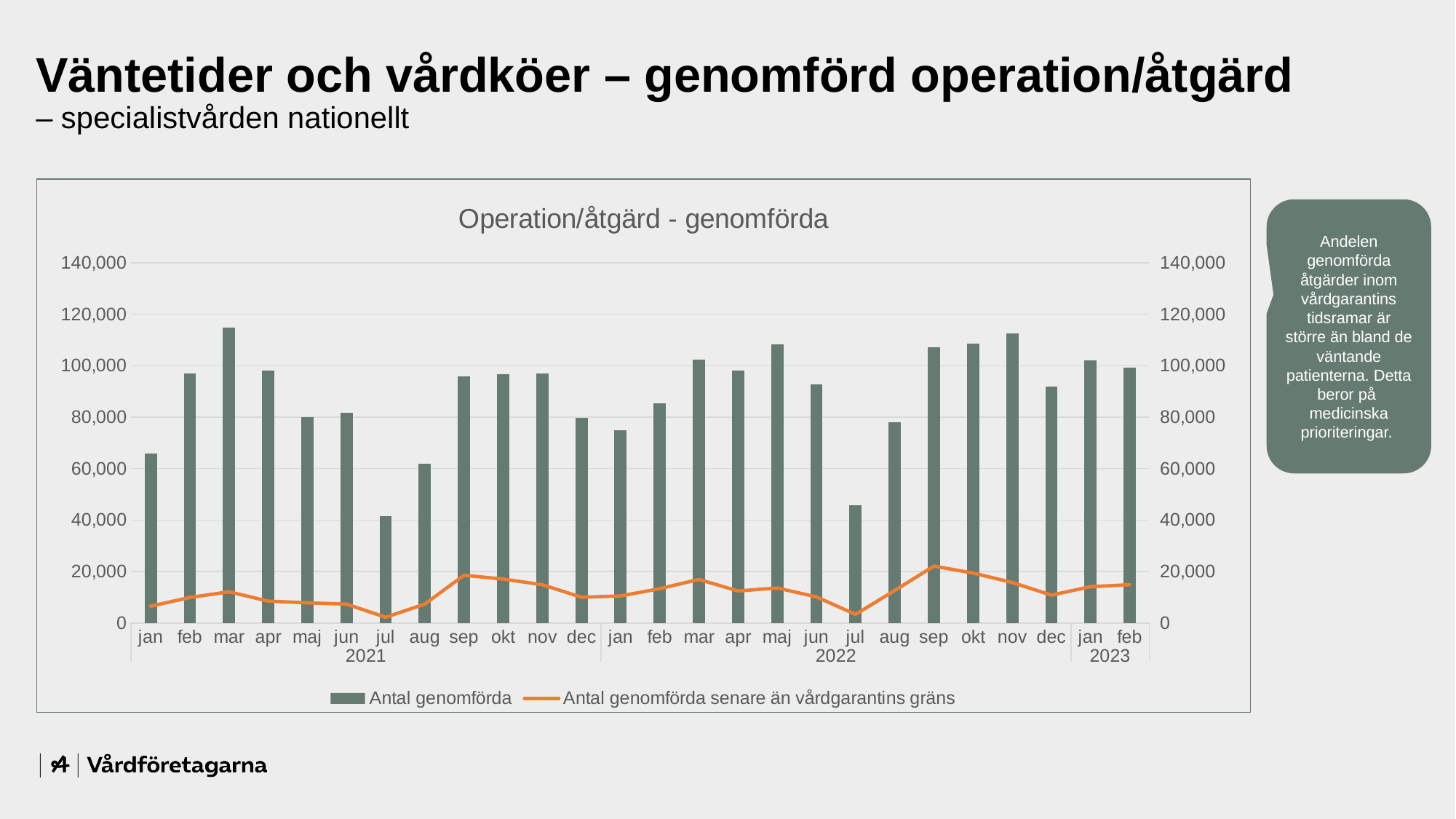
Which is larger, the Antal genomförda bar for mar 2021 or for nov 2022? mar 2021 Is the Antal genomförda value for jul 2022 greater or less than 60,000? less What kind of chart is shown on the slide? A bar chart combined with a line Which is larger, the Antal genomförda bar for jul 2021 or for aug 2021? aug 2021 How many series does the legend list? 2 Is the Antal genomförda value for mar 2021 greater or less than 100,000? greater Is the Antal genomförda value for jan 2021 greater or less than 80,000? less Which month has the lowest bar for Antal genomförda? jul 2021 Do the Antal genomförda bars rise or fall from jul 2022 to nov 2022? rise Which month has the highest bar for Antal genomförda? mar 2021 How many months are plotted on the x axis? 26 In which month does the line 'Antal genomförda senare än vårdgarantins gräns' reach its highest point? sep 2022